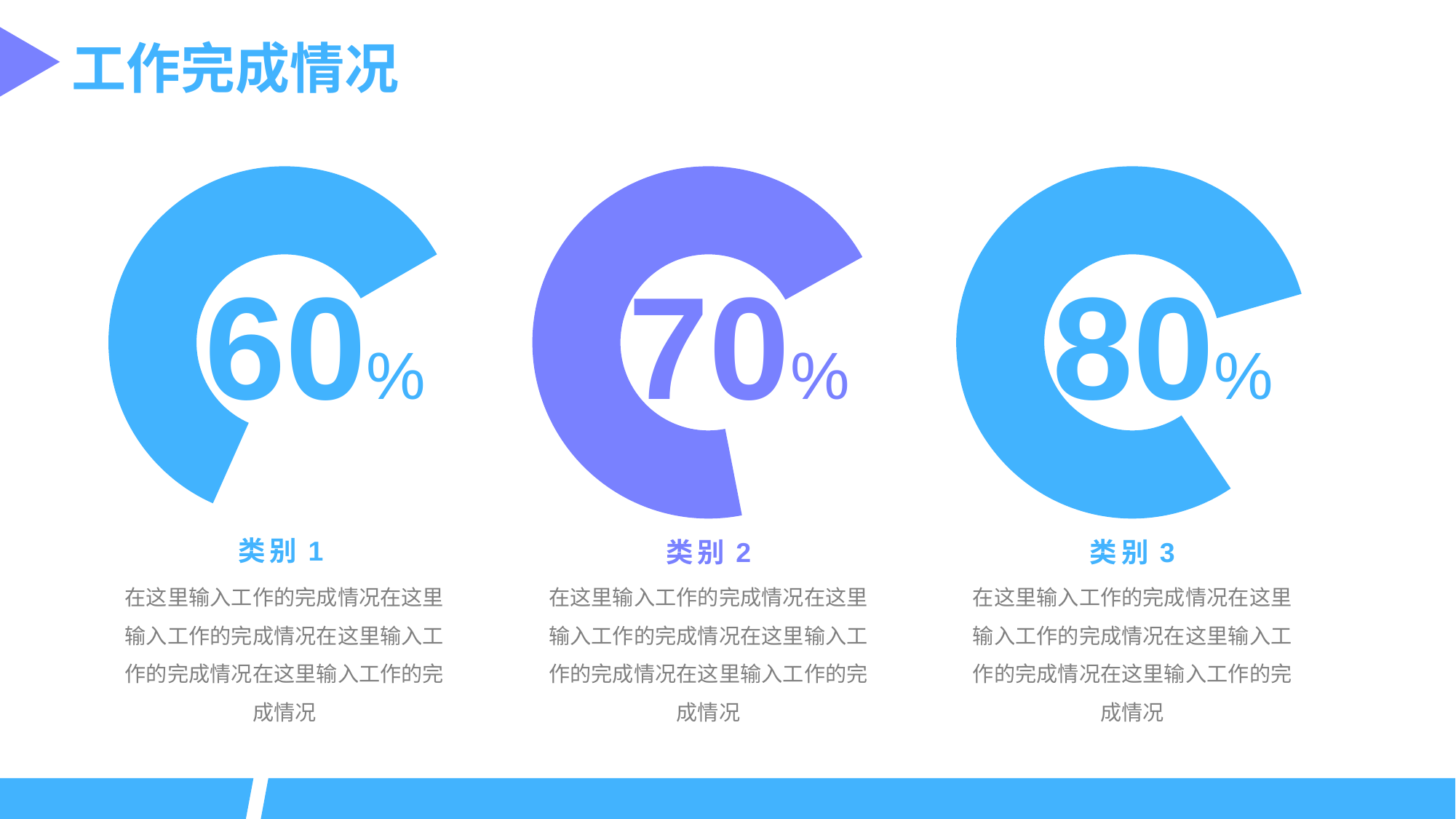
What is the completion value shown for 类别 3? 80% Which category has the highest completion percentage? 类别 3 What is the difference between the values for 类别 2 and 类别 1? 10% Which category has the lowest completion percentage? 类别 1 Do the values rise or fall from 类别 1 to 类别 3? Rise Which is larger, the value for 类别 2 or the value for 类别 3? 类别 3 What is the completion value shown for 类别 2? 70% What kind of chart is used to show each category's value? Doughnut chart What is the difference between the values for 类别 3 and 类别 1? 20% What is the title of the slide? 工作完成情况 How many categories are shown on the slide? 3 What is the completion value shown for 类别 1? 60%